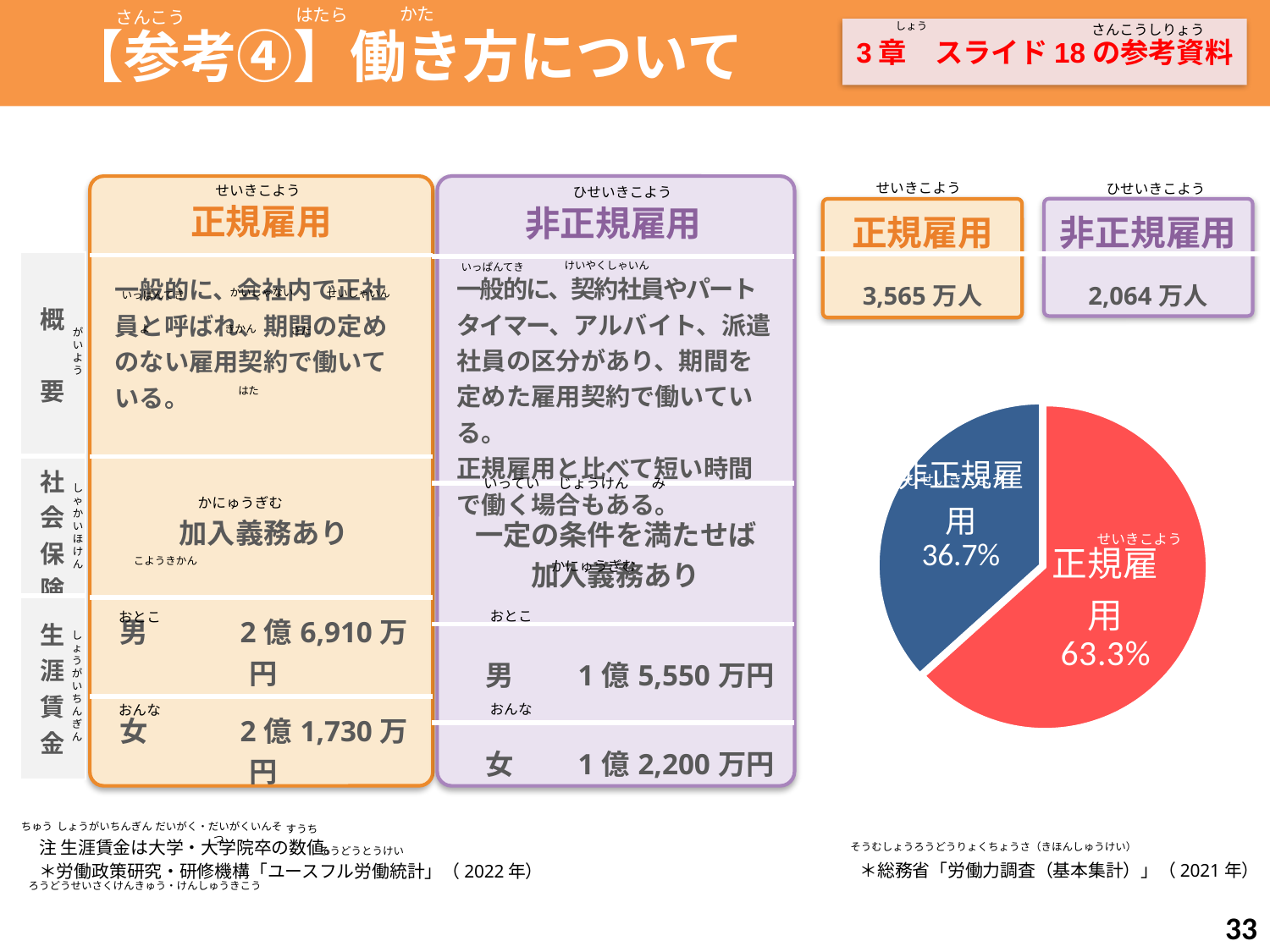
In the pie chart, what share is shown for 非正規雇用? 36.7% In the pie chart, what share is shown for 正規雇用? 63.3% How many slices does the pie chart have? 2 Is the share for 非正規雇用 in the pie chart greater or less than 50%? less In the pie chart, which is larger: 正規雇用 or 非正規雇用? 正規雇用 What colour is the 正規雇用 slice in the pie chart? red By how many percentage points does the 正規雇用 slice exceed the 非正規雇用 slice in the pie chart? 26.6 percentage points Which slice of the pie chart is the largest? 正規雇用 What colour is the 非正規雇用 slice in the pie chart? blue What kind of chart is shown on the right side of the slide? pie chart Which slice of the pie chart is the smallest? 非正規雇用